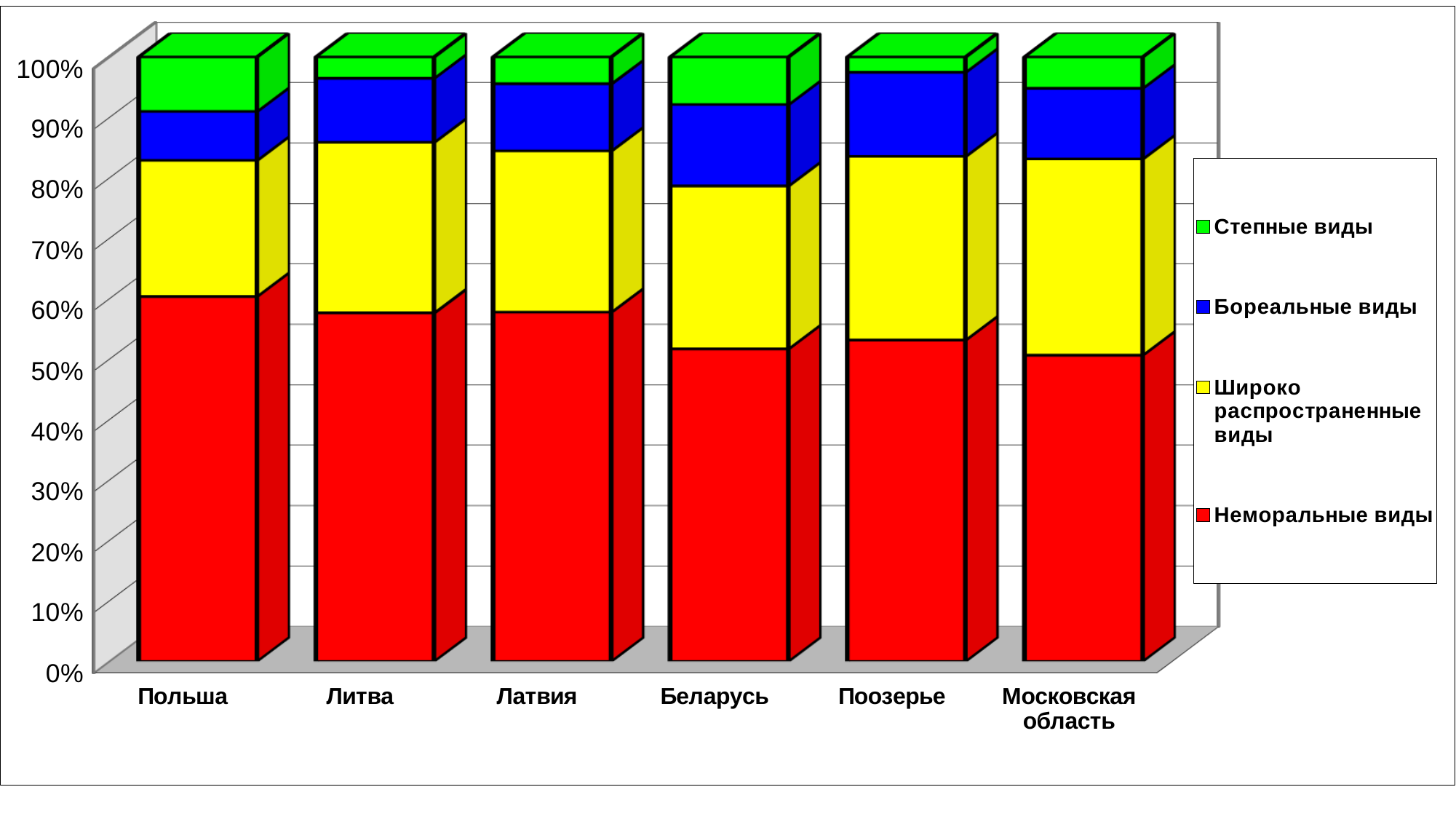
Is the value of Неморальные виды for Беларусь greater or less than 60%? less Which category has the largest Широко распространенные виды segment? Московская область Which series is shown in green at the top of each bar? Степные виды What is the total of the stacked bar for Литва? 100% Is the value of Неморальные виды for Польша greater or less than 50%? greater What kind of chart is shown on the slide? Stacked bar chart Is the value of Неморальные виды for Московская область greater or less than 40%? greater Which category has the smallest Широко распространенные виды segment? Польша Which series is shown in red at the bottom of each bar? Неморальные виды Which is larger, the Неморальные виды share for Польша or for Беларусь? Польша How many categories are shown along the x axis? 6 How many series does the legend list? 4